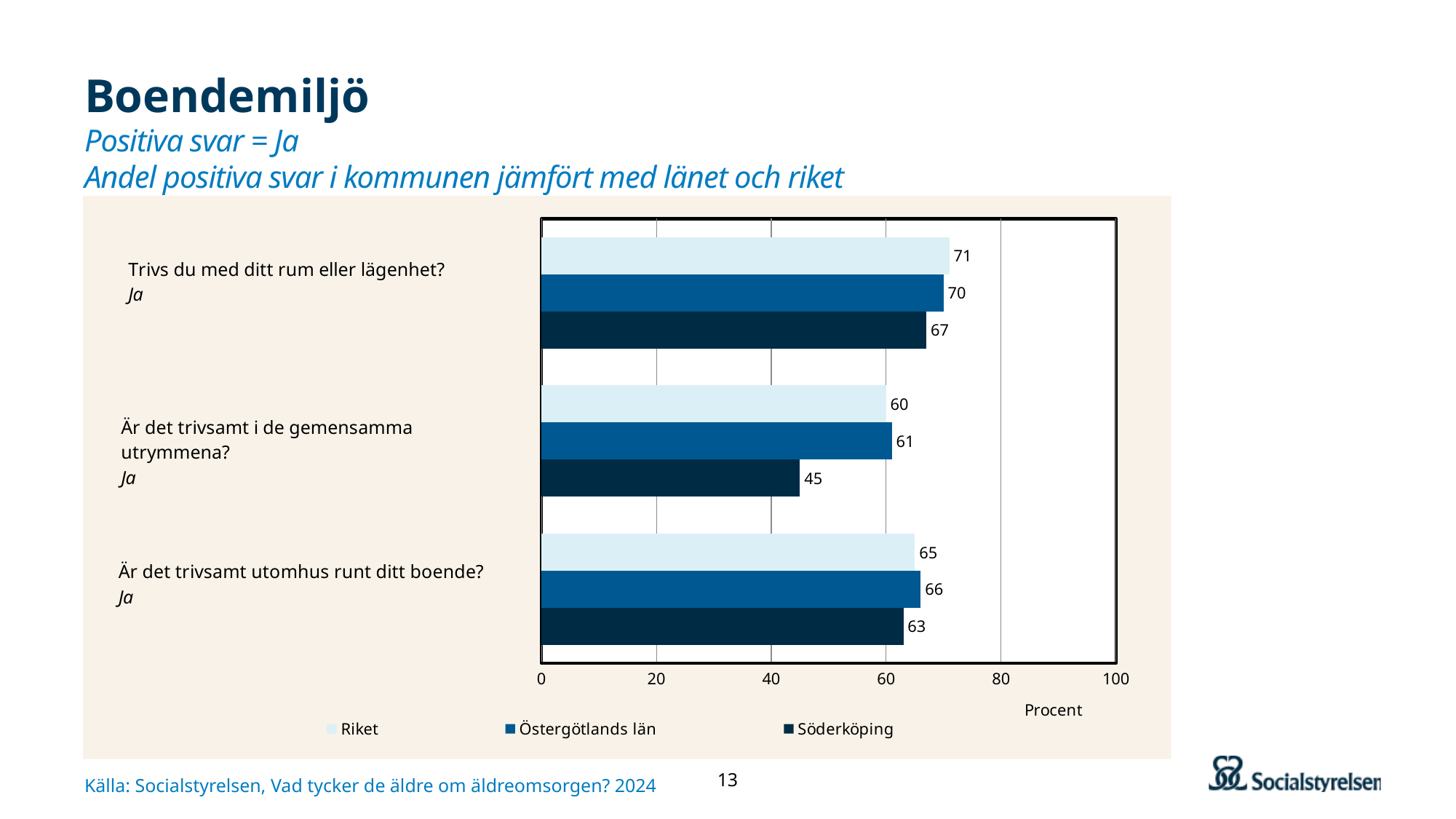
Is the value for Söderköping on "Är det trivsamt i de gemensamma utrymmena?" greater or less than 60? less What is the value for Östergötlands län on "Är det trivsamt utomhus runt ditt boende?"? 66 How many series does the legend list? 3 What kind of chart is shown on the slide? Bar chart Which question has the lowest value for Söderköping? Är det trivsamt i de gemensamma utrymmena? What is the value for Riket on "Trivs du med ditt rum eller lägenhet?"? 71 Which question has the highest value for Riket? Trivs du med ditt rum eller lägenhet? Which is larger on "Trivs du med ditt rum eller lägenhet?": Riket or Söderköping? Riket How many questions (categories) are shown in the chart? 3 What unit label is shown under the x axis? Procent What is the difference between Östergötlands län and Söderköping on "Är det trivsamt i de gemensamma utrymmena?"? 16 What is the value for Söderköping on "Är det trivsamt i de gemensamma utrymmena?"? 45